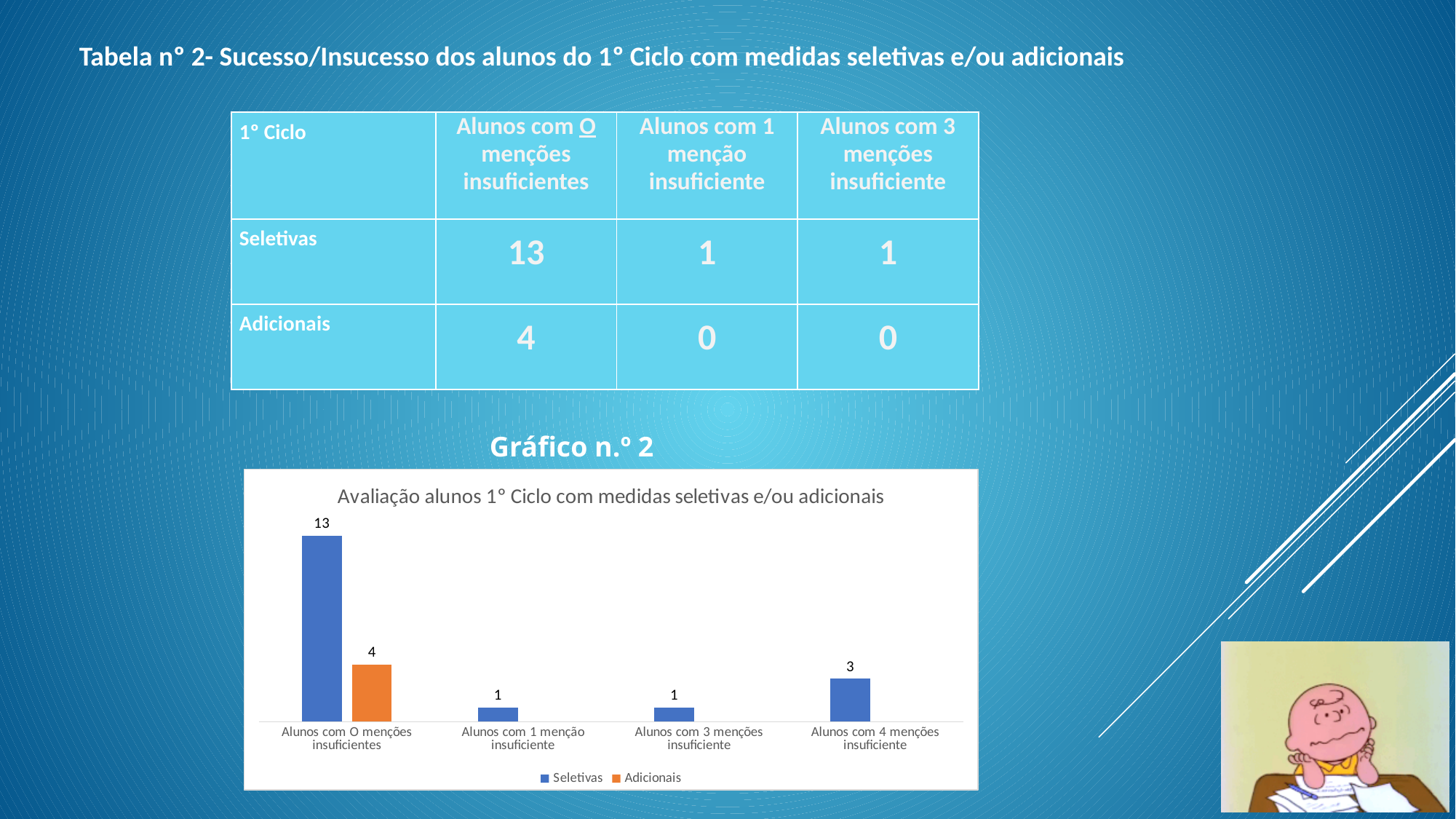
Which category has the highest Seletivas value? Alunos com O menções insuficientes What is the difference between the Seletivas and Adicionais values for 'Alunos com O menções insuficientes'? 9 What is the Seletivas value for 'Alunos com 1 menção insuficiente'? 1 What is the Seletivas value for 'Alunos com 4 menções insuficiente'? 3 Which is larger: the Seletivas value for 'Alunos com 4 menções insuficiente' or the Seletivas value for 'Alunos com 3 menções insuficiente'? Alunos com 4 menções insuficiente What is the Adicionais value for 'Alunos com O menções insuficientes'? 4 What is the title of the chart? Avaliação alunos 1° Ciclo com medidas seletivas e/ou adicionais How many categories are shown on the x axis of the chart? 4 Which colour represents the Adicionais series in the chart? orange What kind of chart is shown on the slide? bar chart What is the Seletivas value for 'Alunos com O menções insuficientes'? 13 How many series does the chart legend list? 2